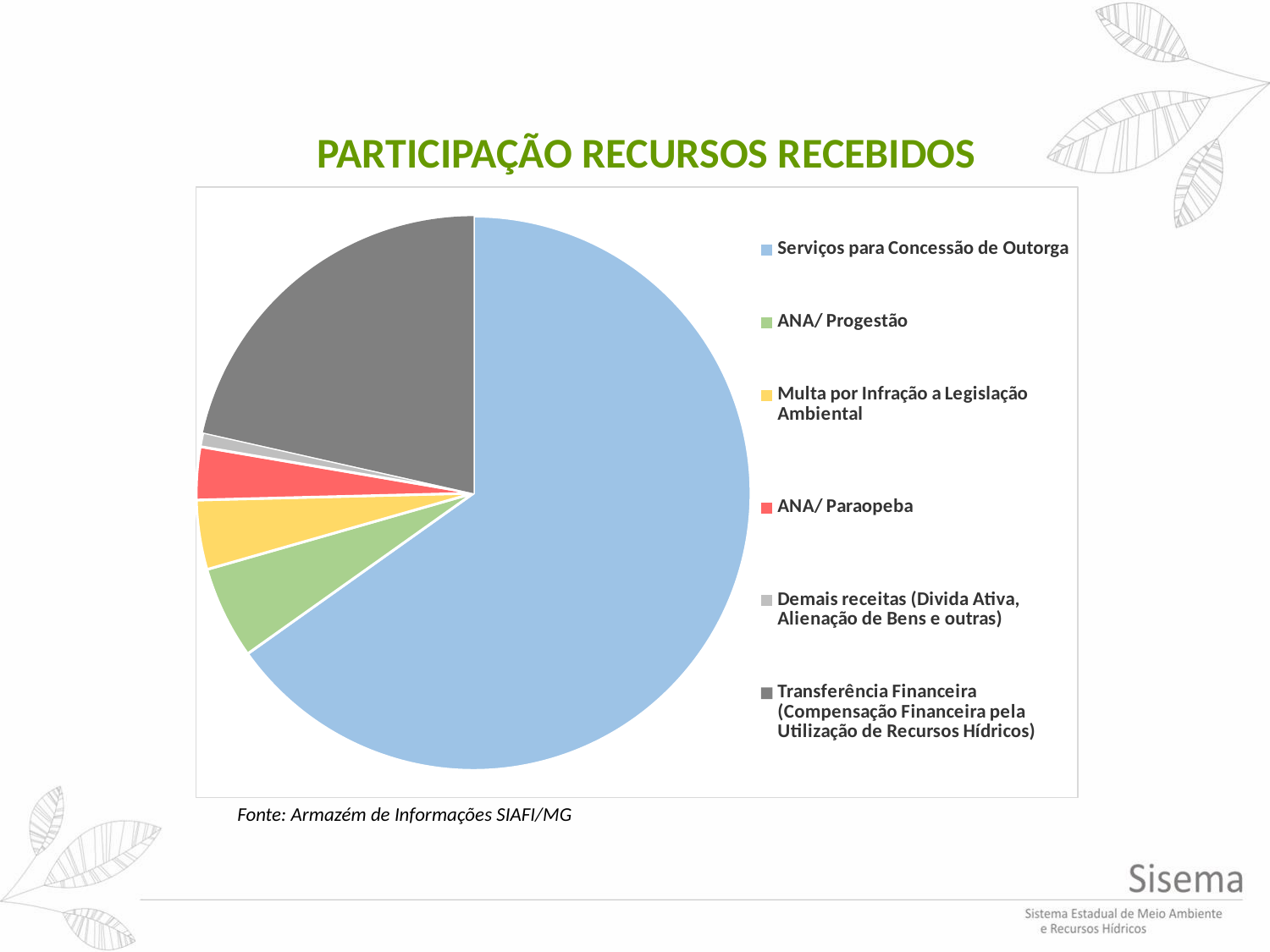
Which slice is larger: Serviços para Concessão de Outorga or Transferência Financeira (Compensação Financeira pela Utilização de Recursos Hídricos)? Serviços para Concessão de Outorga Which slice is larger: Multa por Infração a Legislação Ambiental or Demais receitas (Divida Ativa, Alienação de Bens e outras)? Multa por Infração a Legislação Ambiental How many categories does the pie chart show? 6 Which category has the second-largest slice of the pie? Transferência Financeira (Compensação Financeira pela Utilização de Recursos Hídricos) Which slice is larger: ANA/ Progestão or Demais receitas (Divida Ativa, Alienação de Bens e outras)? ANA/ Progestão What is the title of the chart? PARTICIPAÇÃO RECURSOS RECEBIDOS Which category is shown in red in the pie chart? ANA/ Paraopeba What kind of chart is shown on the slide? pie chart Which category has the largest slice of the pie? Serviços para Concessão de Outorga Which category has the smallest slice of the pie? Demais receitas (Divida Ativa, Alienação de Bens e outras)